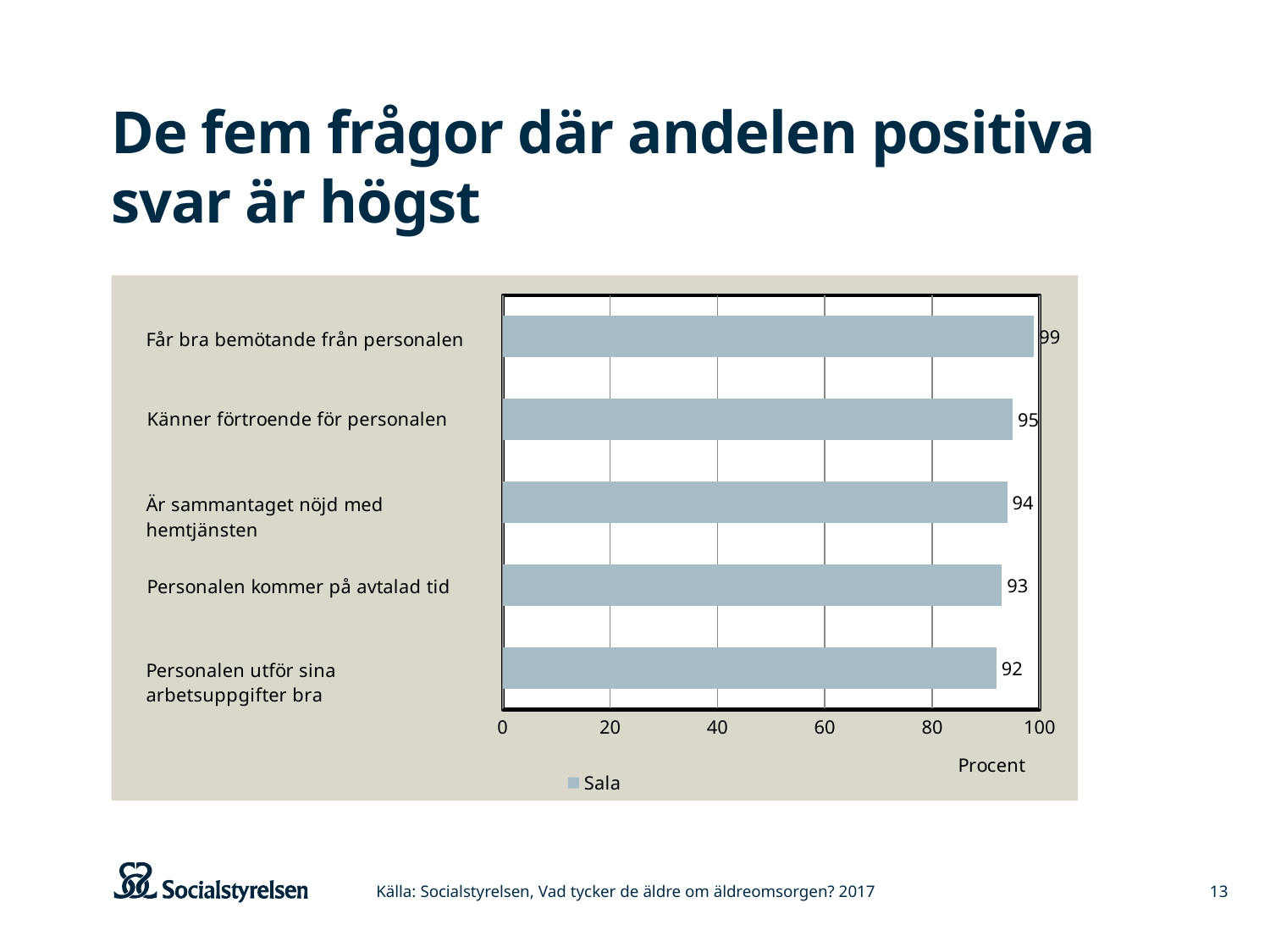
What is the value for "Känner förtroende för personalen"? 95 What is the value for "Får bra bemötande från personalen"? 99 Which is larger: the value for "Känner förtroende för personalen" or "Är sammantaget nöjd med hemtjänsten"? Känner förtroende för personalen What kind of chart is shown on the slide? Bar chart Which category has the highest value? Får bra bemötande från personalen How many categories are shown in the chart? 5 Which category has the lowest value? Personalen utför sina arbetsuppgifter bra What is the difference between the values for "Får bra bemötande från personalen" and "Personalen utför sina arbetsuppgifter bra"? 7 How many series does the legend list? 1 What is the value for "Personalen kommer på avtalad tid"? 93 What is the name of the series shown in the legend? Sala What is the value for "Personalen utför sina arbetsuppgifter bra"? 92